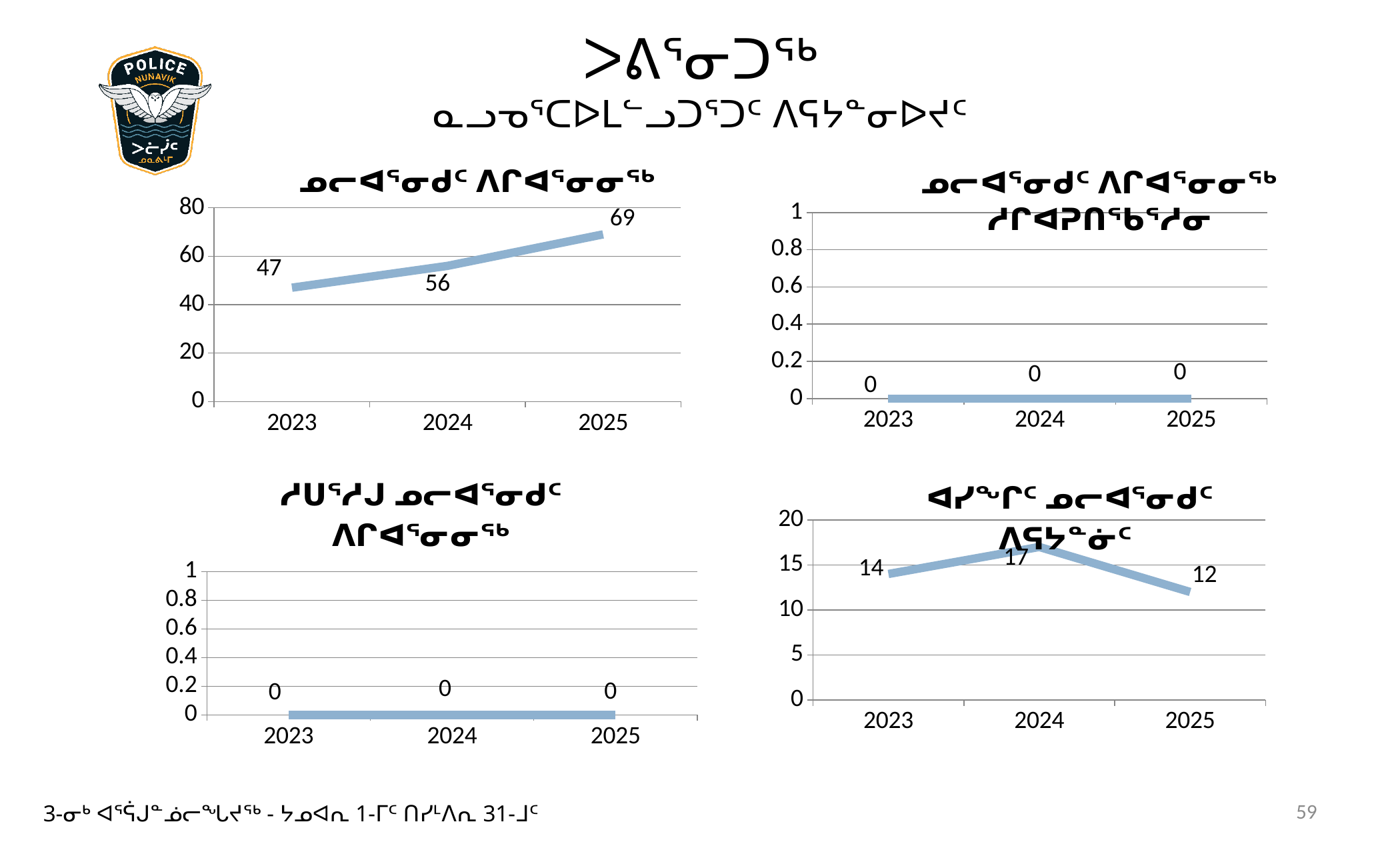
What kind of chart is the bottom-right chart? line chart In the top-right chart, what is the value for 2024? 0 In the top-left chart, what is the value for 2023? 47 In the bottom-right chart, what is the difference between the 2024 and 2025 values? 5 How many years are plotted on the x axis of the bottom-left chart? 3 In the top-left chart, which year has the highest value? 2025 In the top-left chart, do the values rise or fall from 2023 to 2025? rise In the bottom-right chart, is the value for 2023 larger or smaller than the value for 2025? larger In the bottom-right chart, what is the value for 2024? 17 In the bottom-right chart, which year has the lowest value? 2025 In the top-left chart, what is the difference between the 2025 and 2023 values? 22 In the top-left chart, what is the value for 2025? 69